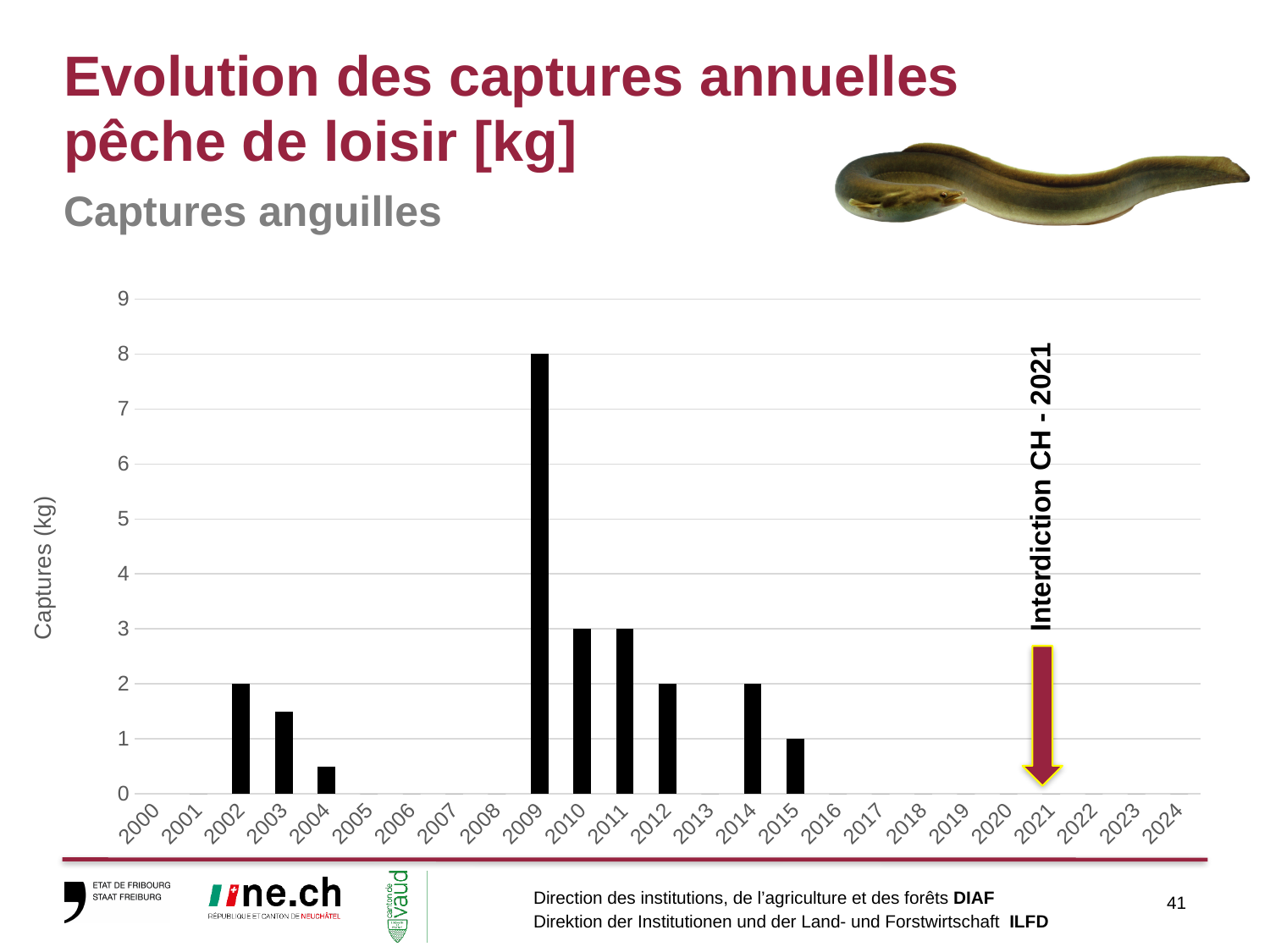
How many years are shown on the x axis of the chart? 25 What is the value for 2009 in the eel captures chart? 8 Is the value for 2003 greater or less than 1? greater Which year has the highest captures in the chart? 2009 What kind of chart is shown on the slide? bar chart What is the difference between the values for 2009 and 2010? 5 What is the label of the y axis? Captures (kg) What is the value for 2010? 3 What is the value for 2015? 1 Is the value for 2004 greater or less than 1? less What is the value for 2014? 2 Which is larger, the value for 2012 or the value for 2015? 2012